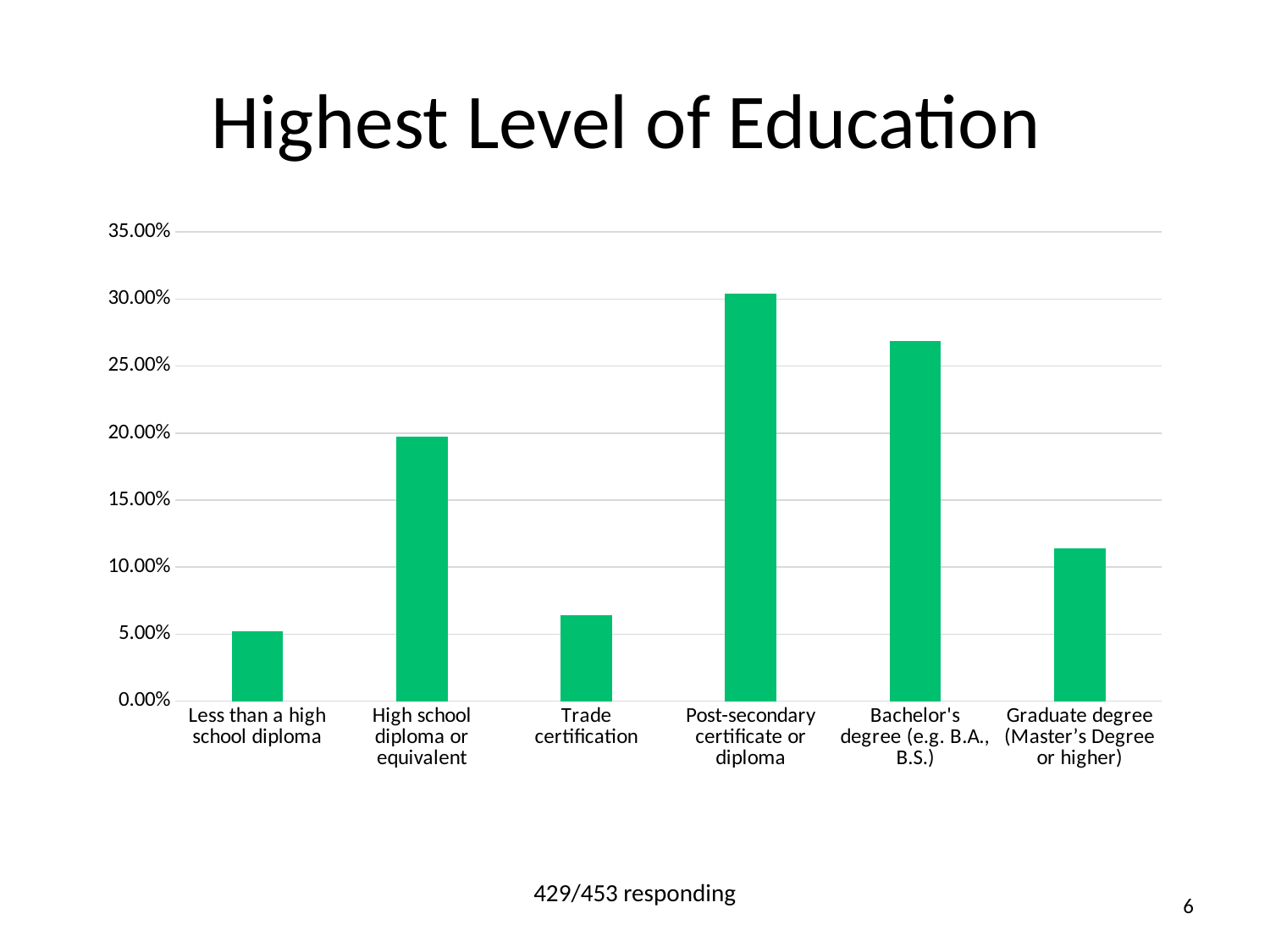
Which education level has the highest percentage? Post-secondary certificate or diploma Which is larger, the value for Post-secondary certificate or diploma or the value for Bachelor's degree (e.g. B.A., B.S.)? Post-secondary certificate or diploma Is the value for Bachelor's degree (e.g. B.A., B.S.) greater or less than 25.00%? greater What is the highest value shown on the y axis? 35.00% What is the title of the chart? Highest Level of Education How many education categories are shown on the x axis? 6 Is the value for Graduate degree (Master's Degree or higher) greater or less than 10.00%? greater Is the value for Less than a high school diploma greater or less than 10.00%? less Which is larger, the value for High school diploma or equivalent or the value for Graduate degree (Master's Degree or higher)? High school diploma or equivalent What kind of chart is shown on the slide? bar chart Which education level has the lowest percentage? Less than a high school diploma